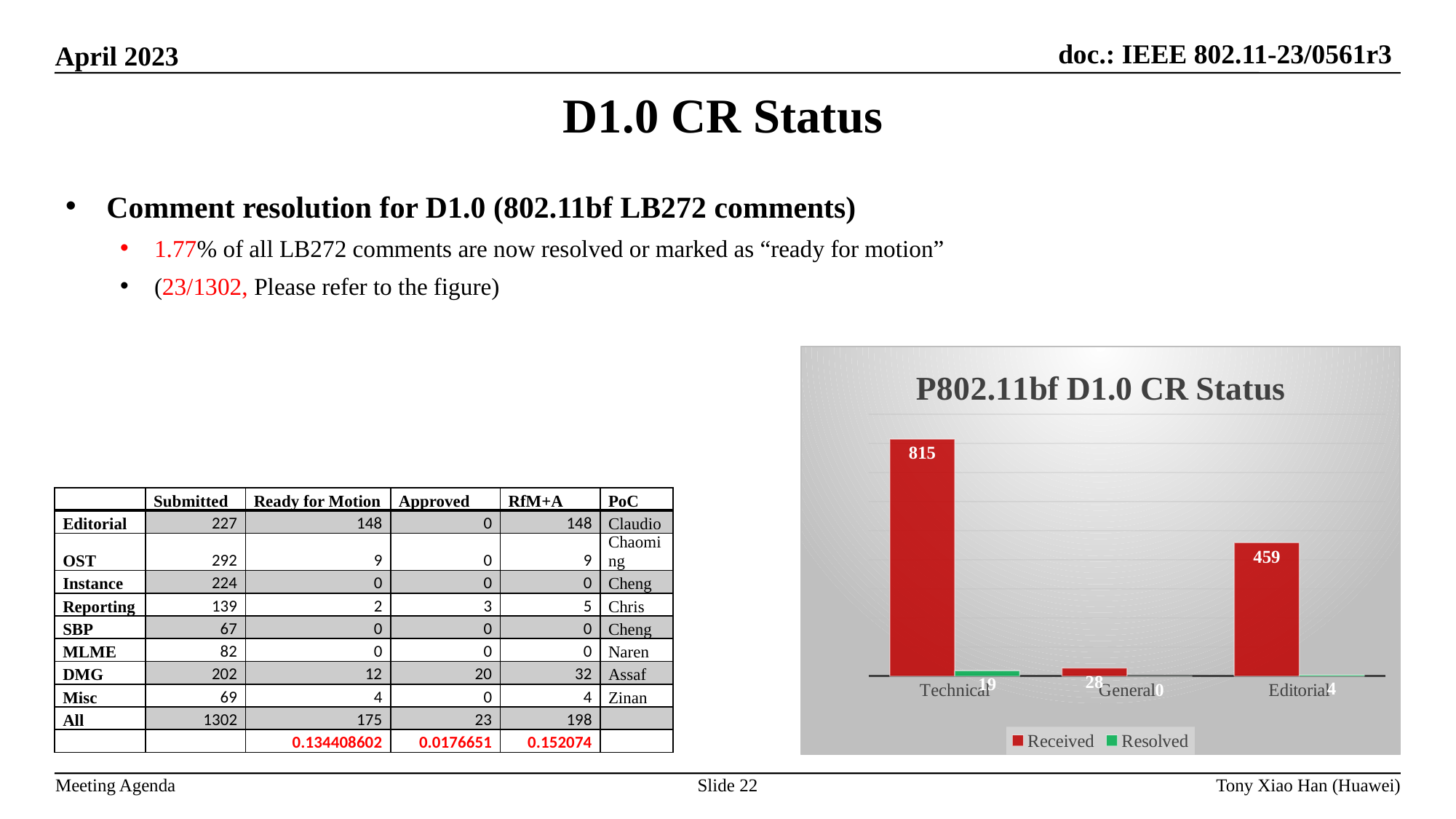
What is the Received value for Technical in the P802.11bf D1.0 CR Status chart? 815 What kind of chart is the P802.11bf D1.0 CR Status chart? bar chart What is the difference between the Received values for Technical and Editorial in the P802.11bf D1.0 CR Status chart? 356 In the P802.11bf D1.0 CR Status chart, is the Received value for Editorial larger or smaller than the Received value for General? larger What is the Resolved value for Technical in the P802.11bf D1.0 CR Status chart? 19 Which category has the lowest Received value in the P802.11bf D1.0 CR Status chart? General What is the Received value for Editorial in the P802.11bf D1.0 CR Status chart? 459 How many categories are shown on the x axis of the P802.11bf D1.0 CR Status chart? 3 Which category has the highest Received value in the P802.11bf D1.0 CR Status chart? Technical What is the Received value for General in the P802.11bf D1.0 CR Status chart? 28 How many series does the legend of the P802.11bf D1.0 CR Status chart list? 2 What is the Resolved value for Editorial in the P802.11bf D1.0 CR Status chart? 4